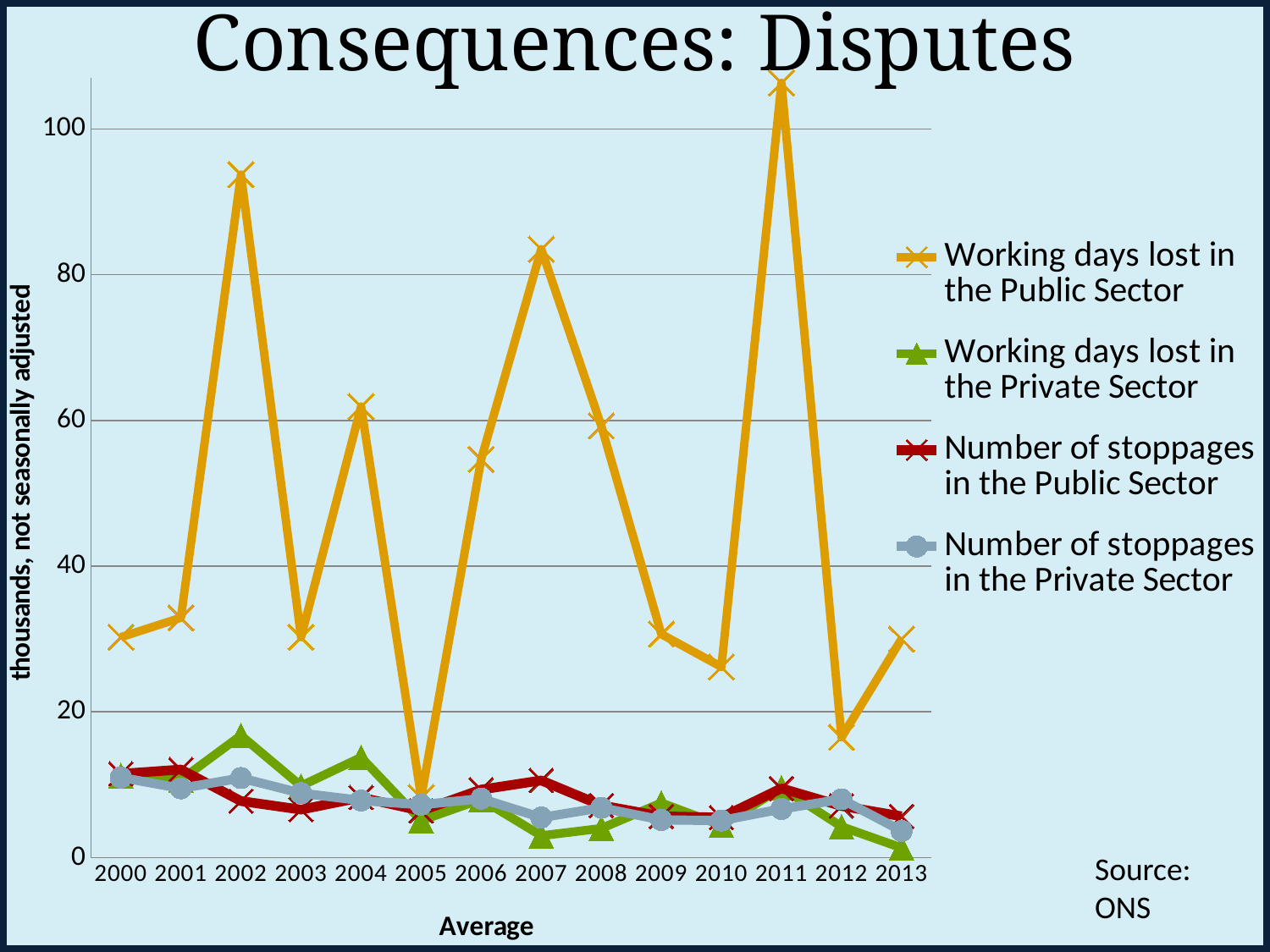
Is the value for Working days lost in the Public Sector in 2002 greater or less than 80? greater In which year is the value for Working days lost in the Public Sector highest? 2011 What is the title of the chart? Consequences: Disputes Is the value for Working days lost in the Public Sector in 2012 greater or less than 20? less What kind of chart is shown on the slide? Line chart In which year is the value for Working days lost in the Private Sector highest? 2002 How many series does the legend list? 4 Do the values for Working days lost in the Private Sector rise or fall from 2011 to 2013? Fall How many years are plotted along the x axis? 14 Which is larger for Working days lost in the Public Sector: the value in 2002 or the value in 2007? 2002 In which year is the value for Working days lost in the Public Sector lowest? 2005 Is the value for Working days lost in the Public Sector in 2011 greater or less than 100? greater